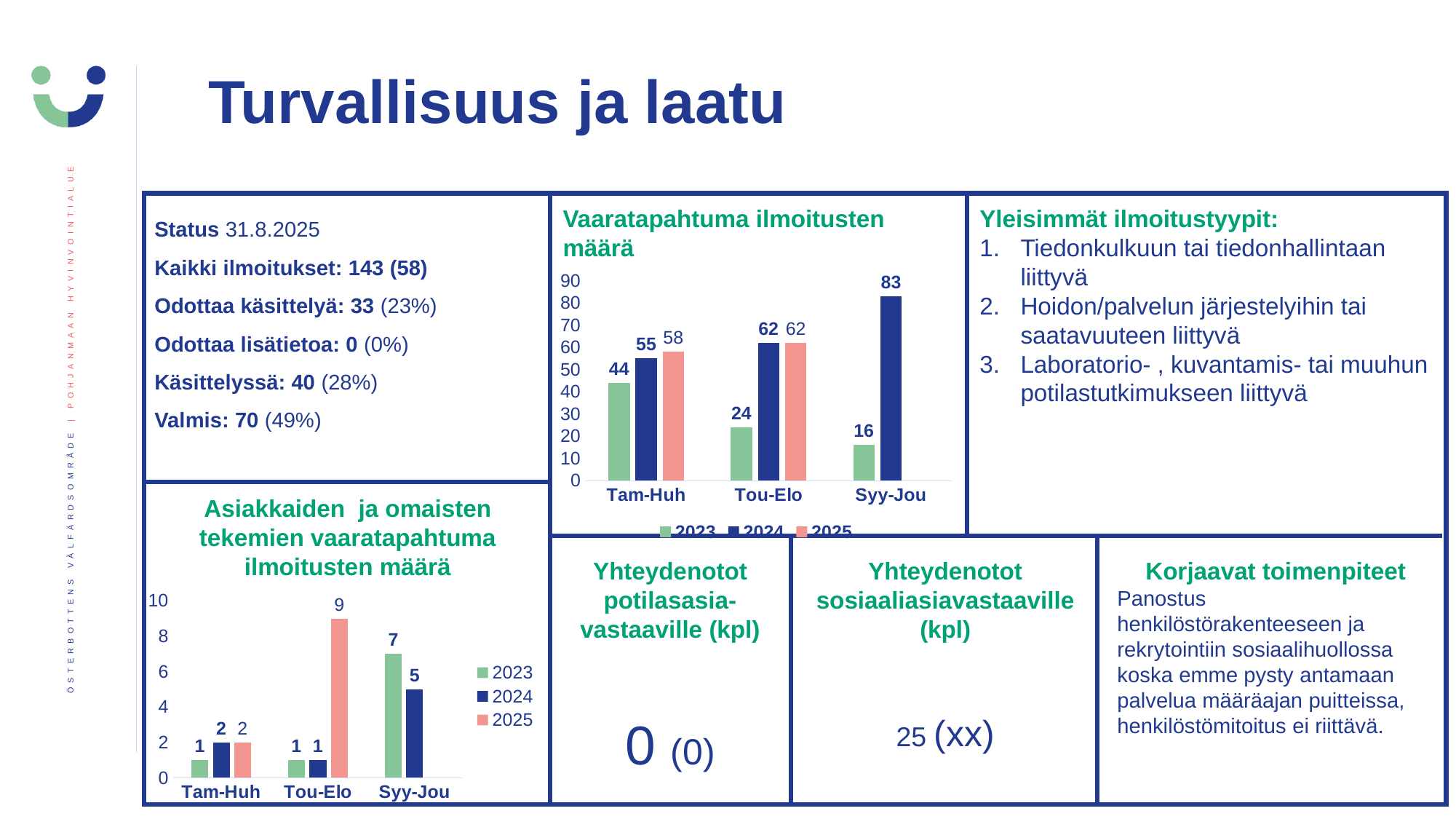
In the 'Asiakkaiden ja omaisten tekemien vaaratapahtuma ilmoitusten määrä' chart, what is the difference between the 2023 and 2024 values in Syy-Jou? 2 In the 'Vaaratapahtuma ilmoitusten määrä' chart, what is the value for 2024 in Syy-Jou? 83 In the 'Vaaratapahtuma ilmoitusten määrä' chart, which period has the highest 2024 value? Syy-Jou In the 'Vaaratapahtuma ilmoitusten määrä' chart, what is the value for 2023 in Tam-Huh? 44 What type of chart is the 'Asiakkaiden ja omaisten tekemien vaaratapahtuma ilmoitusten määrä' chart? Bar chart In the 'Vaaratapahtuma ilmoitusten määrä' chart, how many series does the legend list? 3 In the 'Vaaratapahtuma ilmoitusten määrä' chart, which period has the lowest 2023 value? Syy-Jou In the 'Asiakkaiden ja omaisten tekemien vaaratapahtuma ilmoitusten määrä' chart, what is the value for 2025 in Tou-Elo? 9 In the 'Vaaratapahtuma ilmoitusten määrä' chart, how do the 2023 values change from Tam-Huh to Syy-Jou? They fall In the 'Vaaratapahtuma ilmoitusten määrä' chart, what is the difference between the 2024 and 2023 values in Tou-Elo? 38 In the 'Vaaratapahtuma ilmoitusten määrä' chart, is the 2025 value in Tam-Huh larger or smaller than the 2024 value in Tam-Huh? larger In the 'Asiakkaiden ja omaisten tekemien vaaratapahtuma ilmoitusten määrä' chart, what is the value for 2023 in Syy-Jou? 7